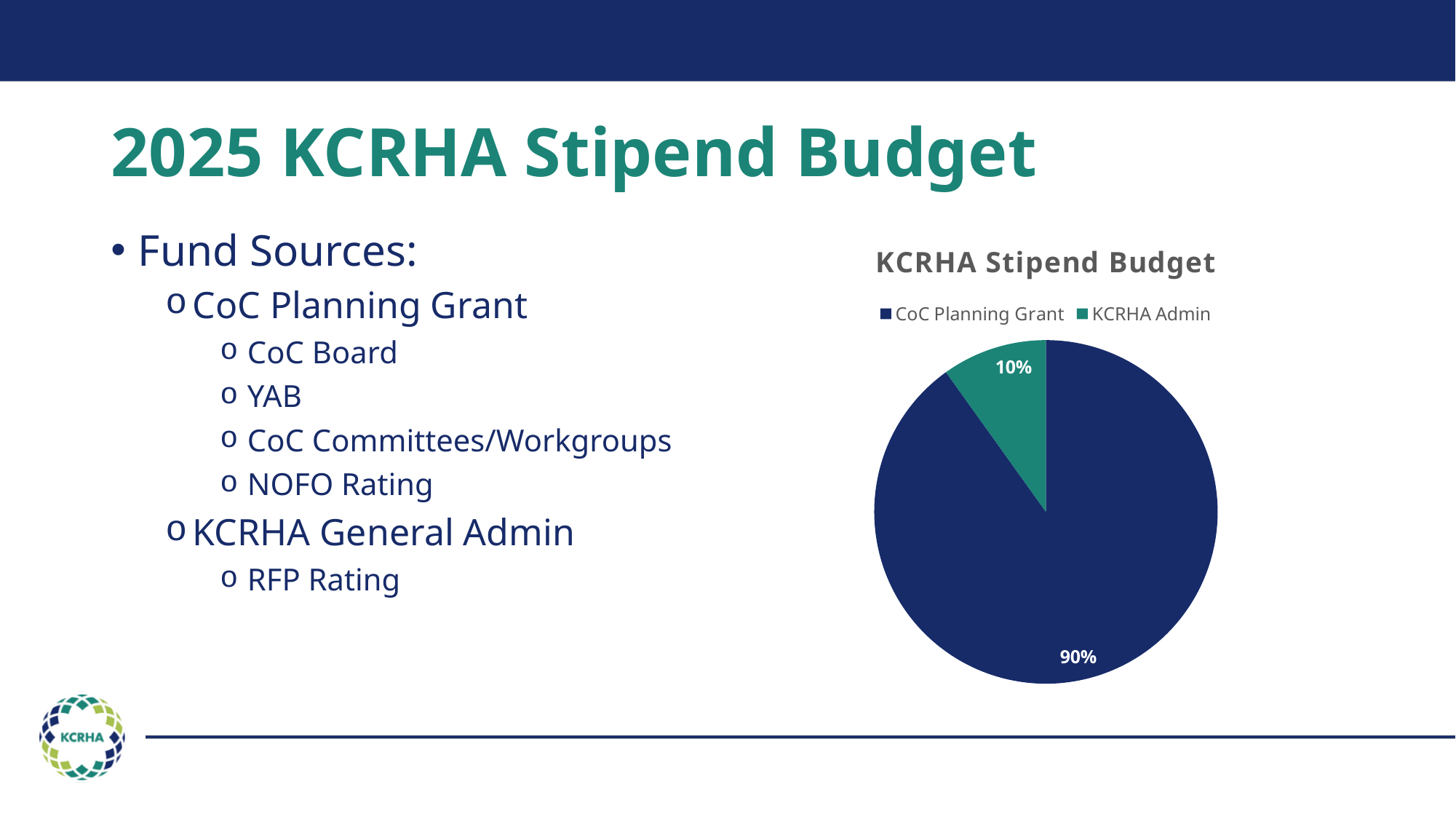
What share of the KCRHA Stipend Budget pie chart is KCRHA Admin? 10% Which is larger in the pie chart, CoC Planning Grant or KCRHA Admin? CoC Planning Grant What share of the KCRHA Stipend Budget pie chart is CoC Planning Grant? 90% How many entries does the chart legend list? 2 What colour is the KCRHA Admin slice in the pie chart? Green What kind of chart is shown on the slide? Pie chart What is the difference in percentage points between the CoC Planning Grant and KCRHA Admin slices? 80 Which slice of the pie chart is the smallest? KCRHA Admin Which slice of the pie chart is the largest? CoC Planning Grant How many slices does the pie chart have? 2 What is the title of the chart? KCRHA Stipend Budget